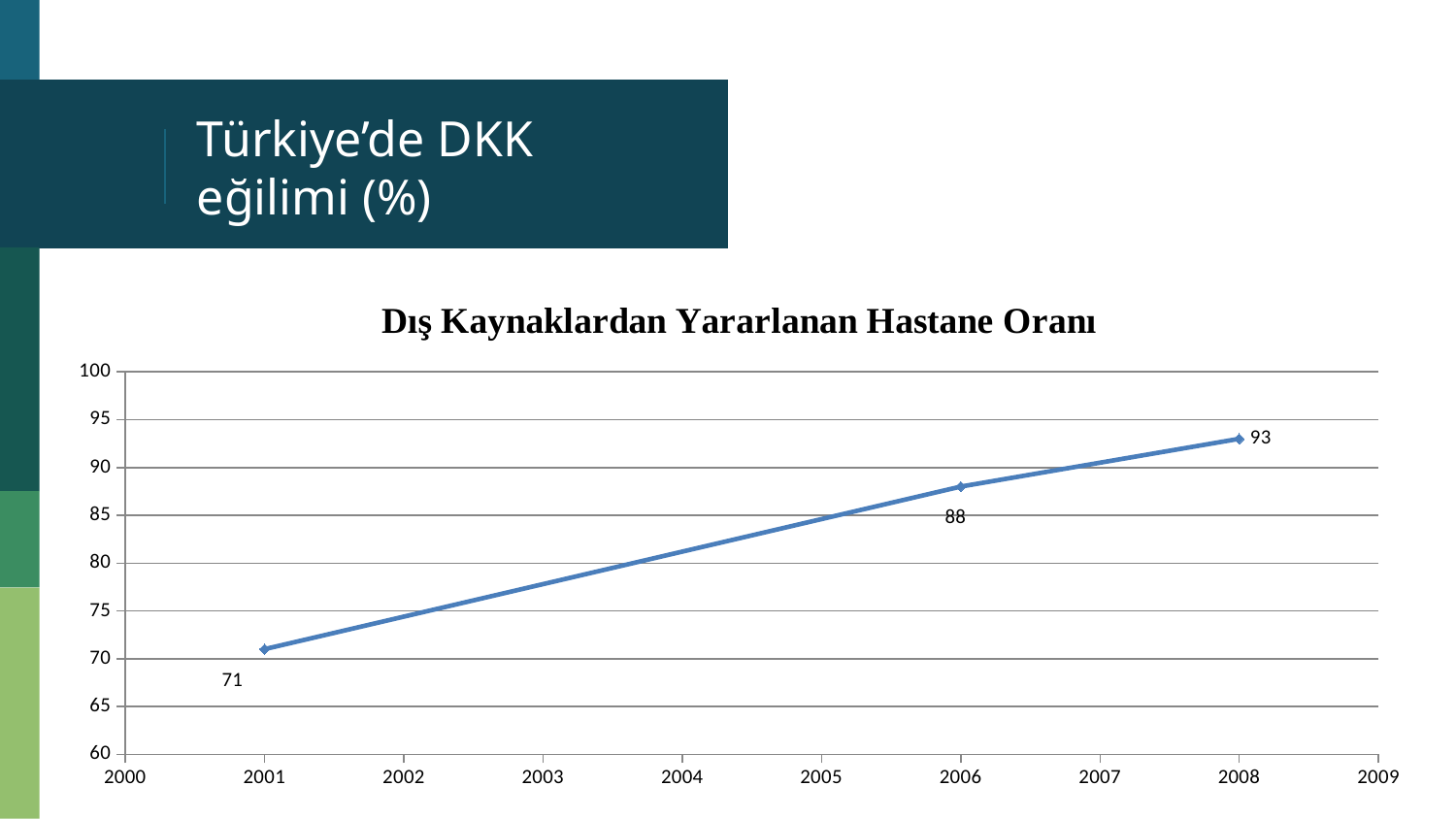
Which year has the lowest value in the chart? 2001 Is the value for 2006 greater or less than 85? greater What is the value for 2006 in the chart? 88 What is the difference between the values for 2008 and 2001? 22 Do the values rise or fall from 2001 to 2008? rise Which year has the highest value in the chart? 2008 What is the value for 2008 in the chart? 93 How many data points are plotted in the chart? 3 What kind of chart is shown on the slide? line chart Which is larger, the value for 2006 or the value for 2008? 2008 What is the value for 2001 in the chart? 71 What is the difference between the values for 2006 and 2001? 17